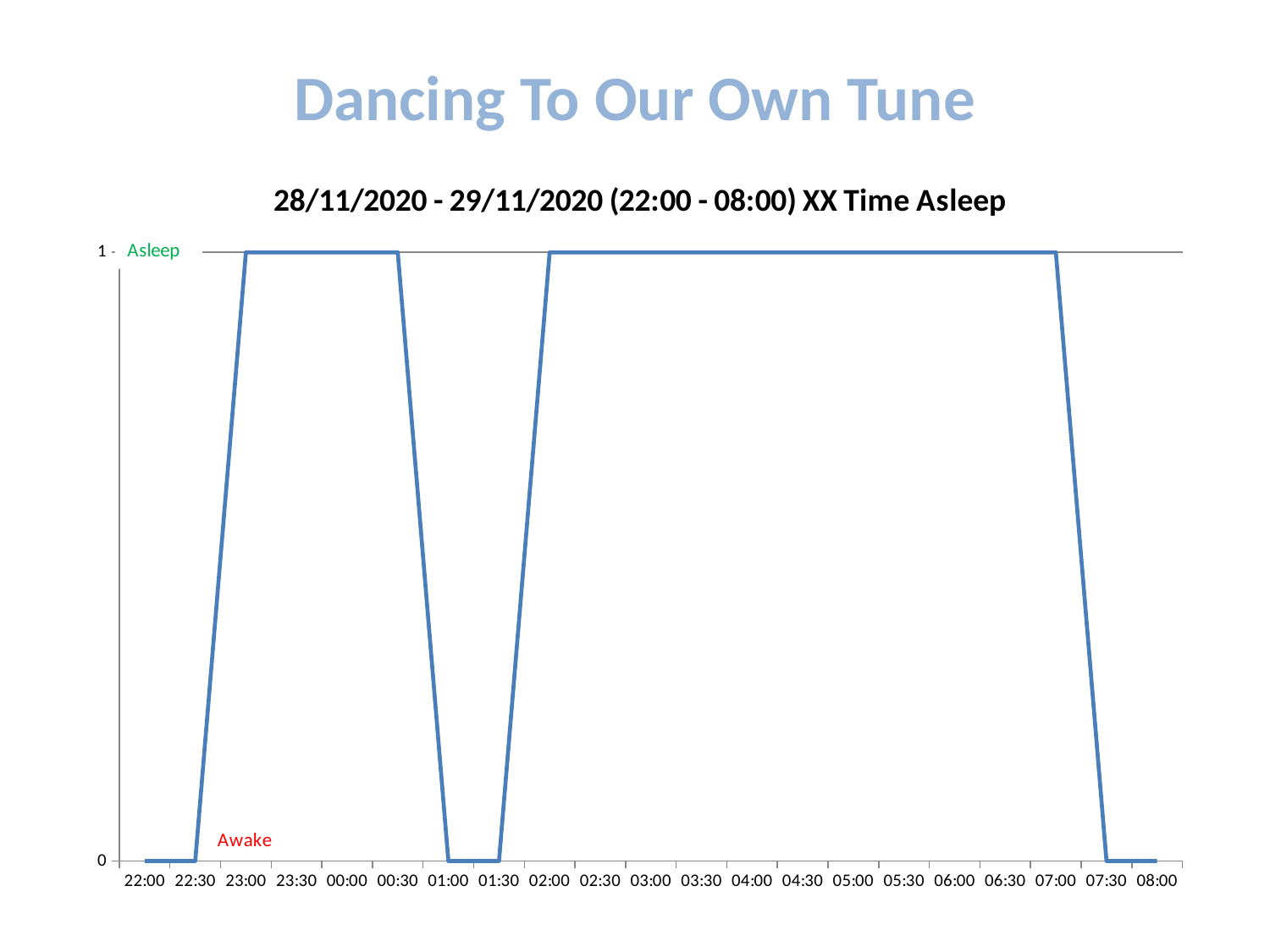
What is the value of the line at 22:00? 0 What is the difference between the value at 05:00 and the value at 07:30? 1 Which label is shown next to the value 1 on the y axis? Asleep What is the value of the line at 04:00? 1 What kind of chart is shown on the slide? line chart Is the value at 03:00 larger than the value at 01:30? yes What is the value of the line at 08:00? 0 What is the value of the line at 23:30? 1 How many time labels are shown on the x axis? 21 Does the line rise or fall between 07:00 and 07:30? fall What is the value of the line at 01:00? 0 What is the title of the chart? 28/11/2020 - 29/11/2020 (22:00 - 08:00) XX Time Asleep